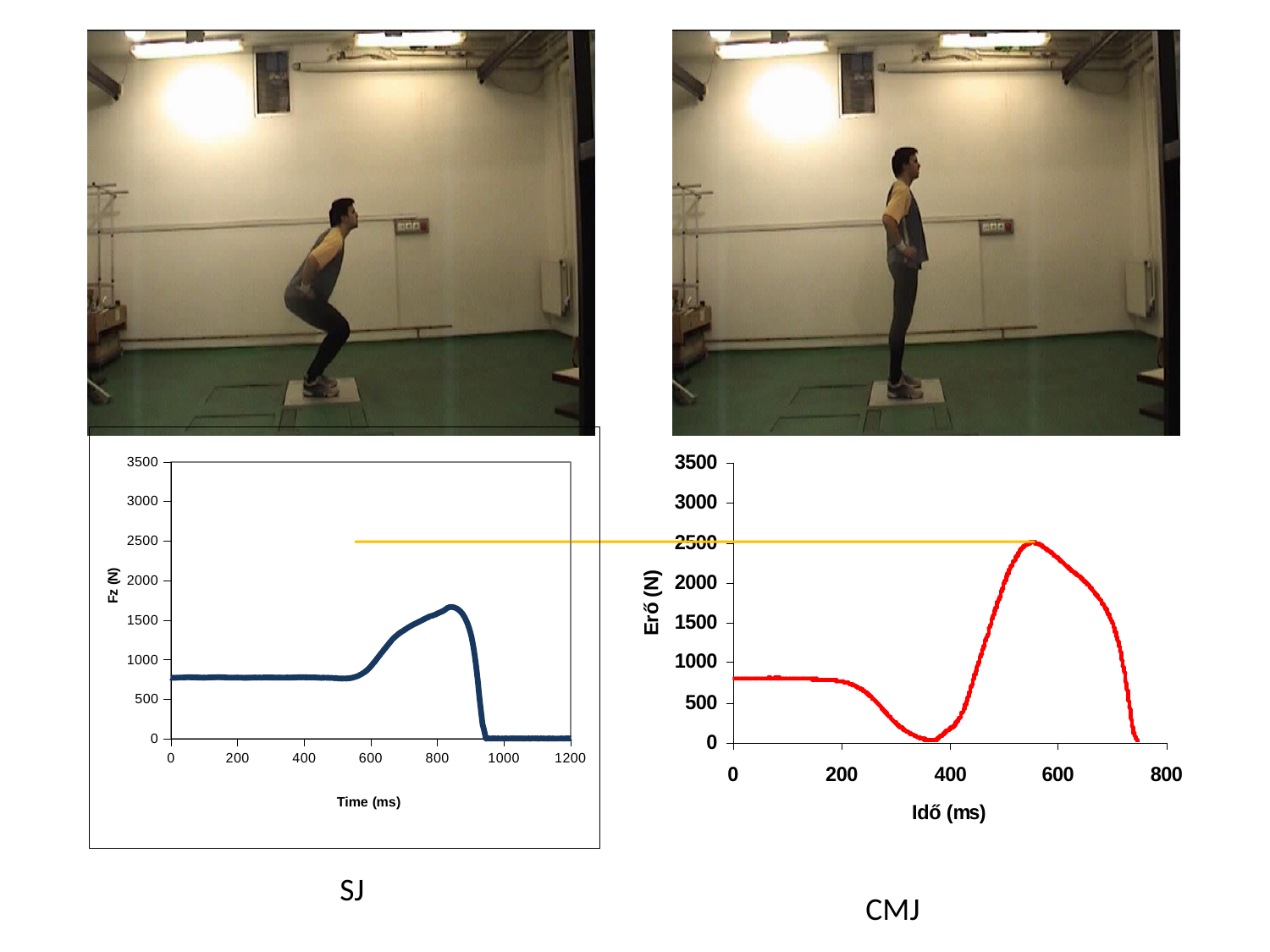
On the CMJ chart, is the peak force value greater or less than 2000? greater On the CMJ chart, is the lowest force value (near 400 ms) greater or less than 500? less On the SJ chart, is the force value at 200 ms greater or less than 1000? less On the SJ chart, what is the highest tick value shown on the x axis? 1200 Which chart reaches the higher peak force, SJ or CMJ? CMJ What kind of chart is the SJ chart on the left? line chart On the SJ chart, what is the label of the x axis? Time (ms) On the CMJ chart, what is the label of the y axis? Erő (N) What kind of chart is the CMJ chart on the right? line chart